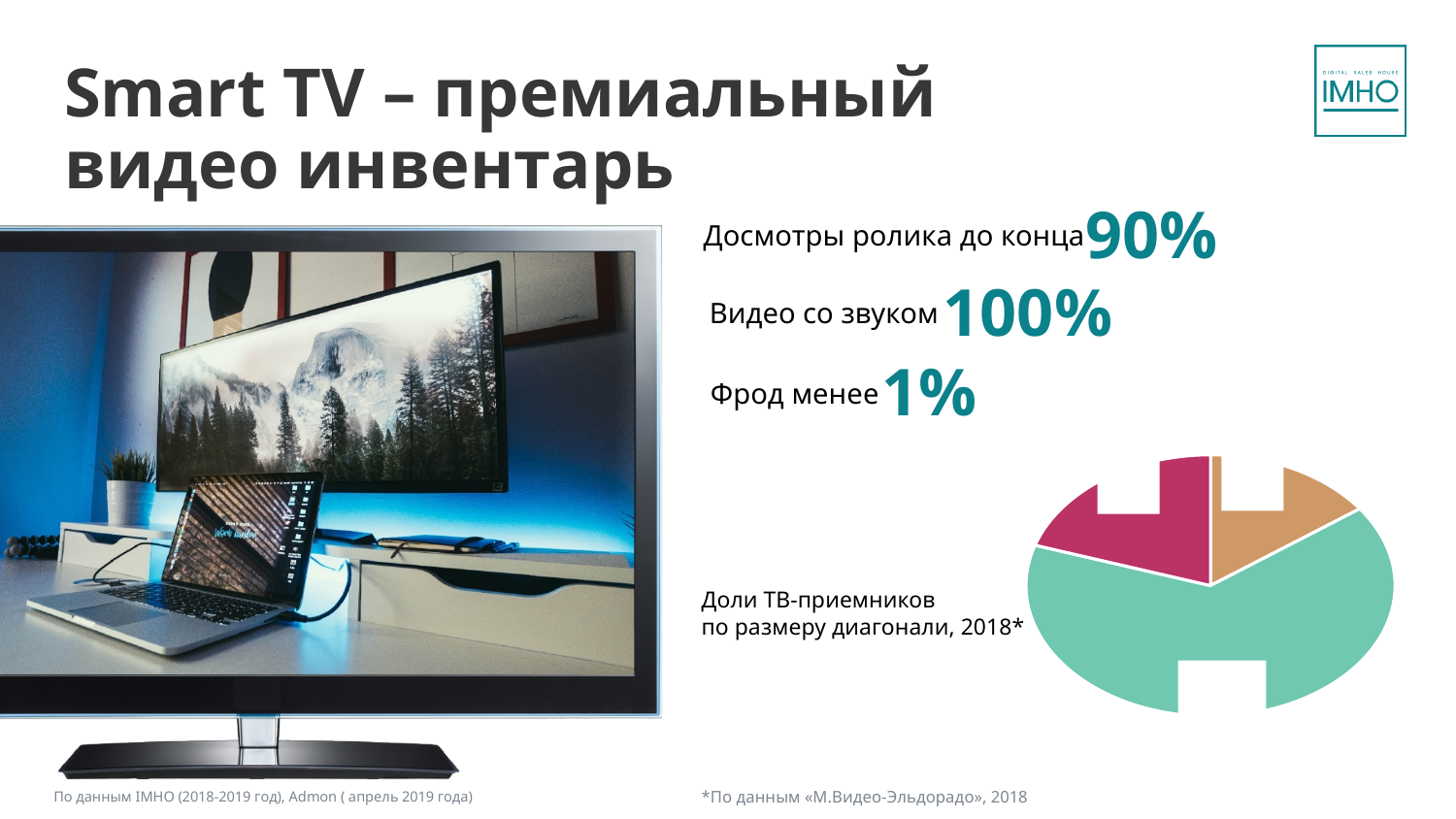
In the pie chart "Доли ТВ-приемников по размеру диагонали, 2018*", which colour slice is the largest? teal (green) How many slices does the pie chart "Доли ТВ-приемников по размеру диагонали, 2018*" have? 3 In the pie chart "Доли ТВ-приемников по размеру диагонали, 2018*", which is larger: the pink slice or the tan slice? the pink slice What kind of chart is shown on the right side of the slide under the heading "Доли ТВ-приемников по размеру диагонали, 2018*"? pie chart In the pie chart "Доли ТВ-приемников по размеру диагонали, 2018*", which is larger: the teal slice or the pink slice? the teal slice Does the teal slice of the pie chart "Доли ТВ-приемников по размеру диагонали, 2018*" take up more or less than half of the pie? more What is the title of the pie chart on the slide? Доли ТВ-приемников по размеру диагонали, 2018* Which year does the pie chart "Доли ТВ-приемников по размеру диагонали" refer to? 2018 In the pie chart "Доли ТВ-приемников по размеру диагонали, 2018*", which colour slice is the smallest? tan (brown)